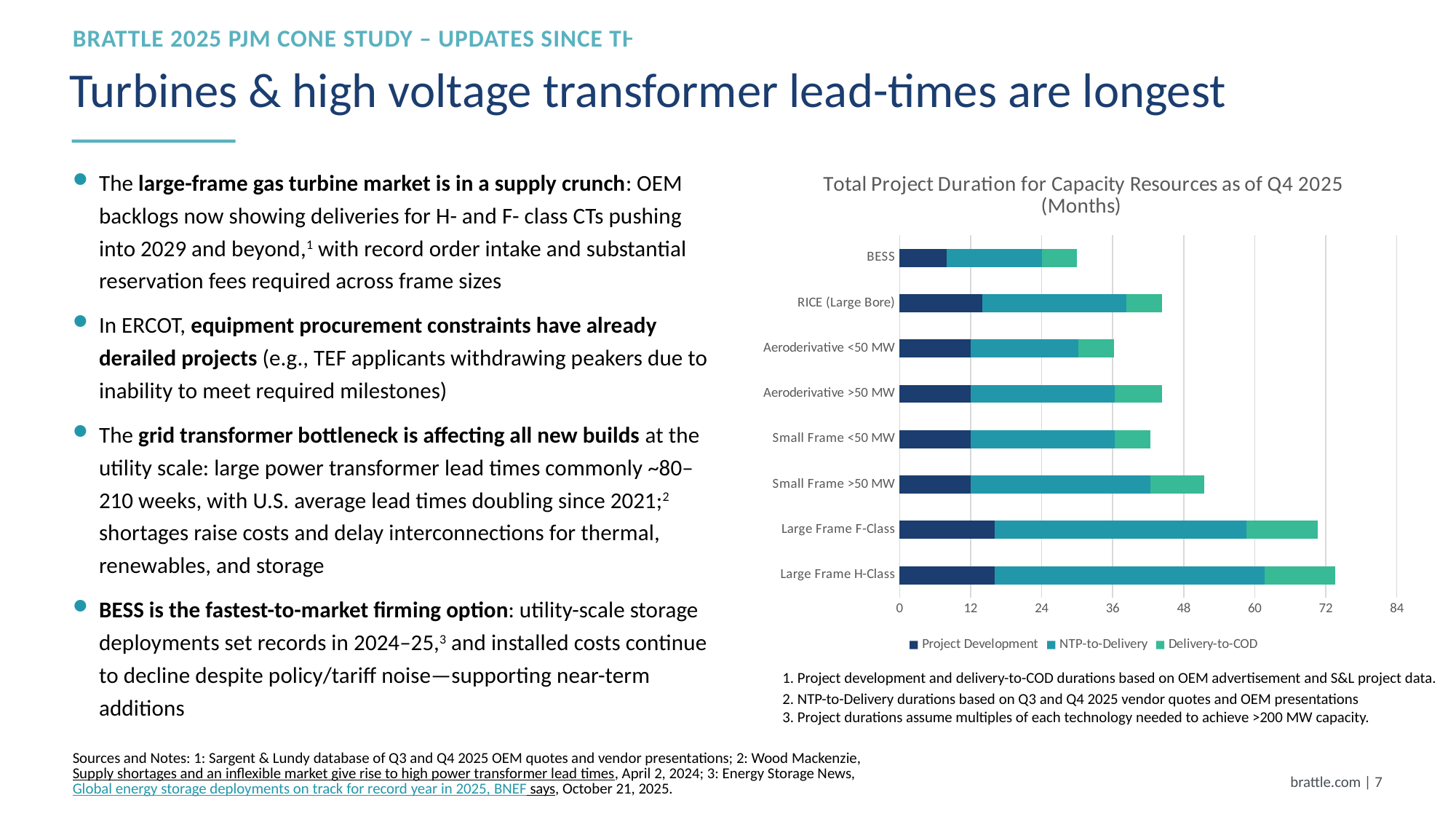
Is the total project duration for Small Frame >50 MW greater or less than 48 months? greater Which series is shown in the darkest blue in the chart legend? Project Development Is the total project duration for RICE (Large Bore) greater or less than 48 months? less Which capacity resource has the shortest total project duration? BESS How many capacity resource categories are plotted in the chart? 8 How many series does the chart legend list? 3 What is the title of the chart? Total Project Duration for Capacity Resources as of Q4 2025 (Months) Is the total project duration for Large Frame H-Class greater or less than 72 months? greater Which capacity resource has the longest total project duration? Large Frame H-Class What kind of chart is shown on the slide? Stacked bar chart Which has a longer total project duration, Small Frame >50 MW or Small Frame <50 MW? Small Frame >50 MW